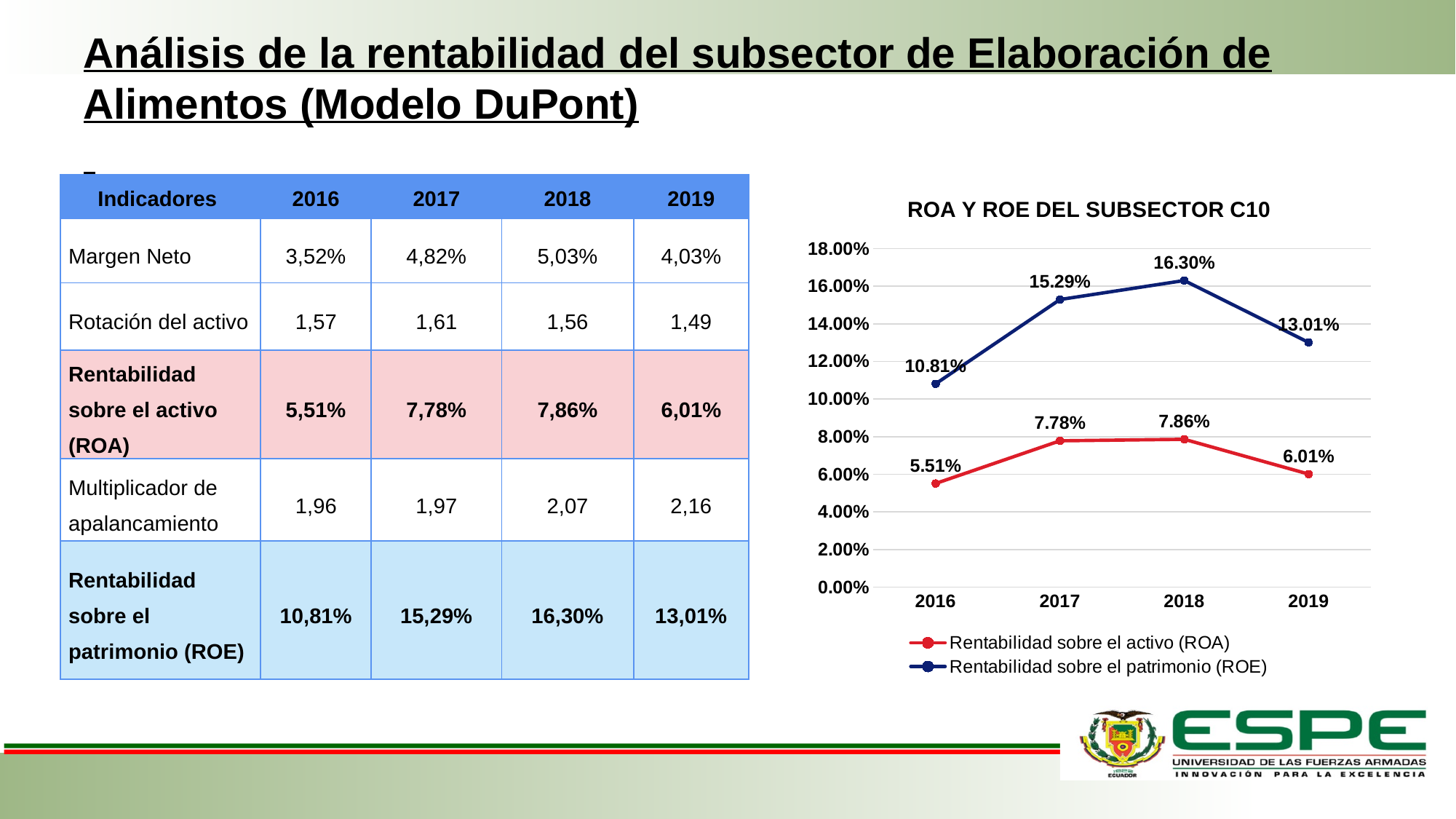
What is the ROA value for 2016 in the chart? 5.51% What kind of chart is shown on the slide? Line chart Which is larger in 2017: ROE or ROA? ROE What is the difference between ROE and ROA in 2018? 8.44% Does ROE rise or fall from 2018 to 2019? Fall How many years are plotted on the x axis of the chart? 4 What is the ROA value for 2017 in the chart? 7.78% What is the ROE value for 2019 in the chart? 13.01% How many series does the chart legend list? 2 What is the title of the chart? ROA Y ROE DEL SUBSECTOR C10 In which year is ROA lowest in the chart? 2016 In which year is ROE highest in the chart? 2018